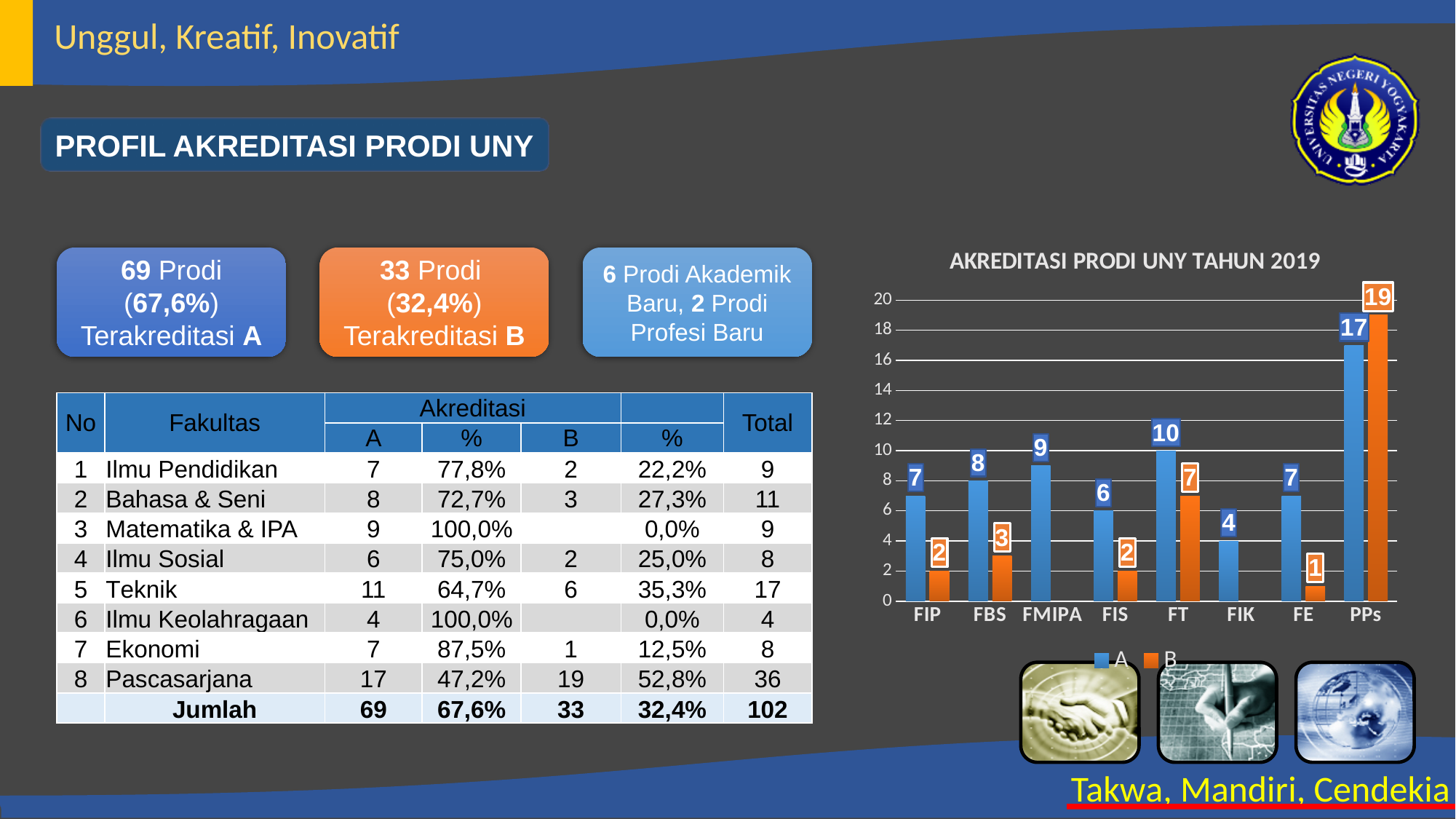
How many categories are shown on the x axis of the chart? 8 What is the value of series A for FIK in the chart? 4 What is the difference between series B and series A for PPs in the chart? 2 What is the title of the chart on the slide? AKREDITASI PRODI UNY TAHUN 2019 Which category has the highest value for series A in the chart? PPs What type of chart is shown on the slide? Bar chart What is the value of series A for FT in the chart? 10 How many series does the chart legend list? 2 What is the value of series B for PPs in the chart? 19 Which category has the lowest value for series A in the chart? FIK What is the value of series B for FE in the chart? 1 Which is larger in the chart: series A for FBS or series A for FMIPA? FMIPA